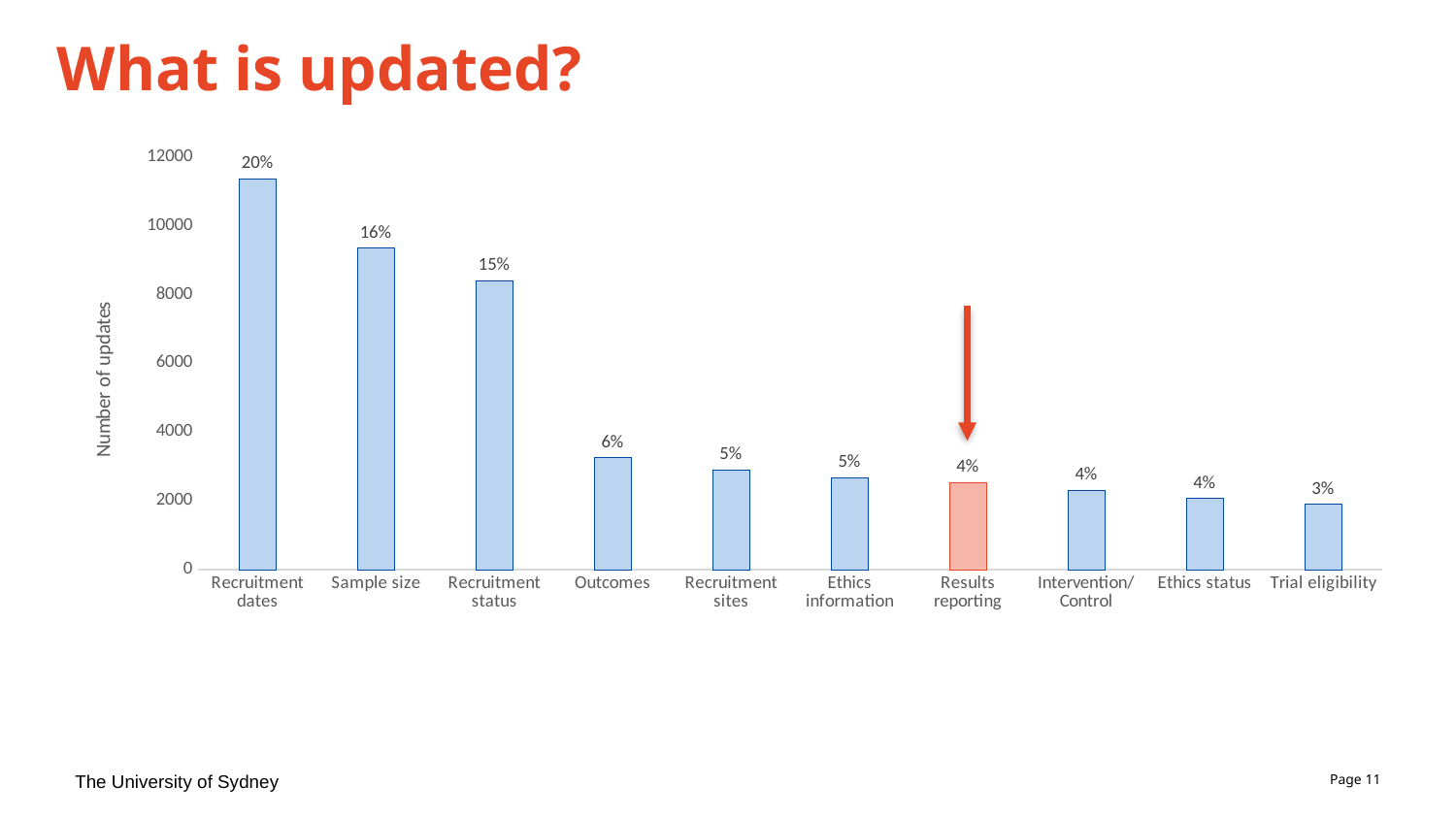
Is the number of updates for Recruitment dates greater or less than 10000? greater What percentage label is shown above the Trial eligibility bar? 3% Which category has the highest number of updates? Recruitment dates Which has a higher percentage label, Outcomes or Recruitment sites? Outcomes What percentage label is shown above the Sample size bar? 16% Which category's bar is highlighted in red/orange with an arrow pointing to it? Results reporting What percentage label is shown above the Results reporting bar? 4% Which category has the lowest number of updates? Trial eligibility What percentage label is shown above the Recruitment dates bar? 20% What is the difference between the percentage labels for Recruitment dates and Sample size? 4% How many categories are shown on the x axis? 10 Is the number of updates for Outcomes greater or less than 4000? less